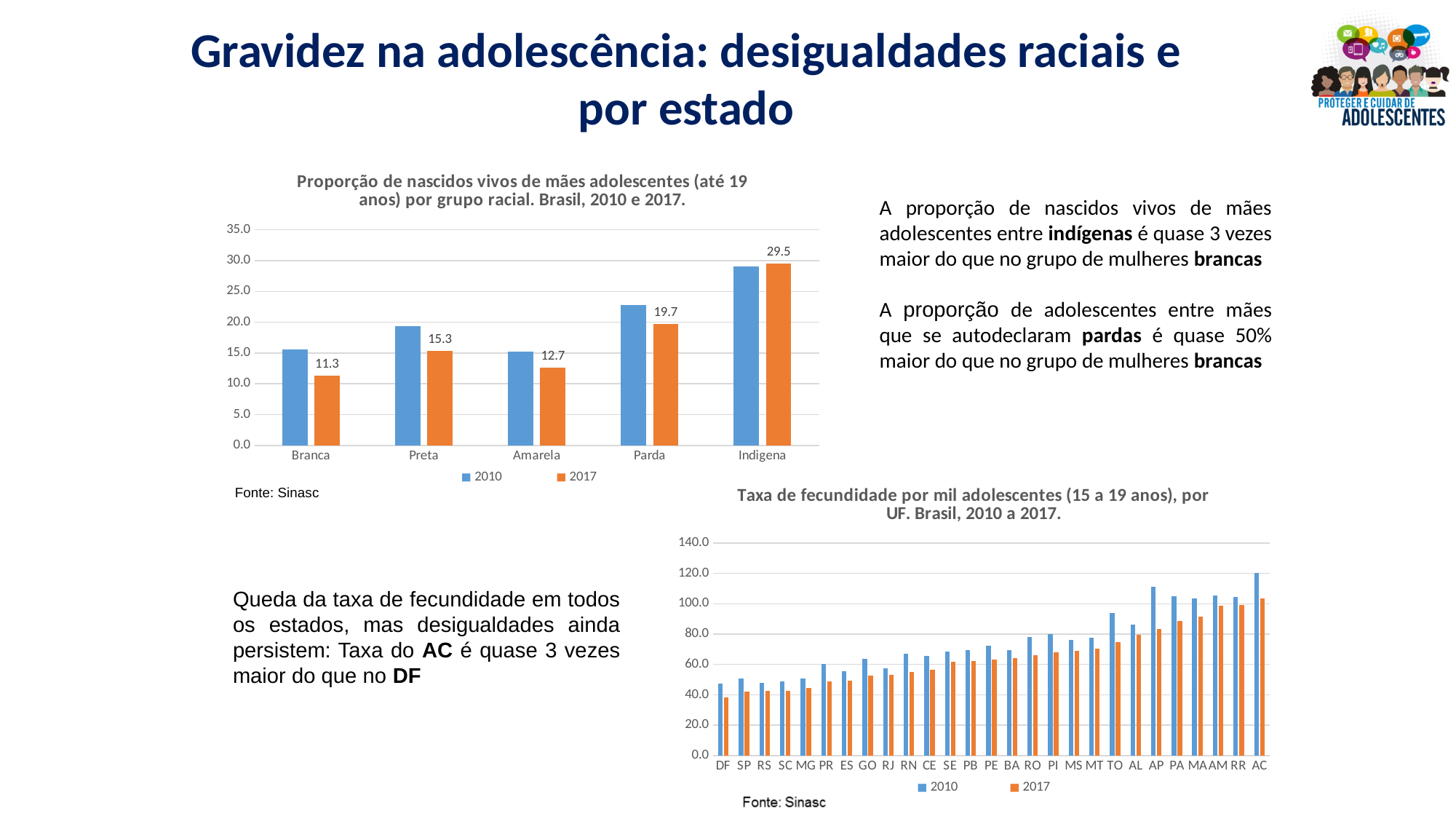
In the chart titled 'Proporção de nascidos vivos de mães adolescentes (até 19 anos) por grupo racial', which racial group has the highest 2017 value? Indigena In the chart titled 'Proporção de nascidos vivos de mães adolescentes (até 19 anos) por grupo racial', which racial group has the lowest 2017 value? Branca In the chart titled 'Taxa de fecundidade por mil adolescentes (15 a 19 anos), por UF', which UF has the highest 2010 value? AC In the chart titled 'Proporção de nascidos vivos de mães adolescentes (até 19 anos) por grupo racial', what is the 2017 value for Parda? 19.7 In the chart titled 'Proporção de nascidos vivos de mães adolescentes (até 19 anos) por grupo racial', what is the 2017 value for Indigena? 29.5 In the chart titled 'Taxa de fecundidade por mil adolescentes (15 a 19 anos), por UF', how many series does the legend list? 2 In the chart titled 'Proporção de nascidos vivos de mães adolescentes (até 19 anos) por grupo racial', is the 2010 value for Parda greater or less than 20.0? greater In the chart titled 'Proporção de nascidos vivos de mães adolescentes (até 19 anos) por grupo racial', what is the difference between the 2017 values for Preta and Amarela? 2.6 In the chart titled 'Proporção de nascidos vivos de mães adolescentes (até 19 anos) por grupo racial', how many racial groups are shown on the x axis? 5 In the chart titled 'Proporção de nascidos vivos de mães adolescentes (até 19 anos) por grupo racial', what is the 2017 value for Branca? 11.3 What kind of chart is the chart titled 'Taxa de fecundidade por mil adolescentes (15 a 19 anos), por UF'? Bar chart